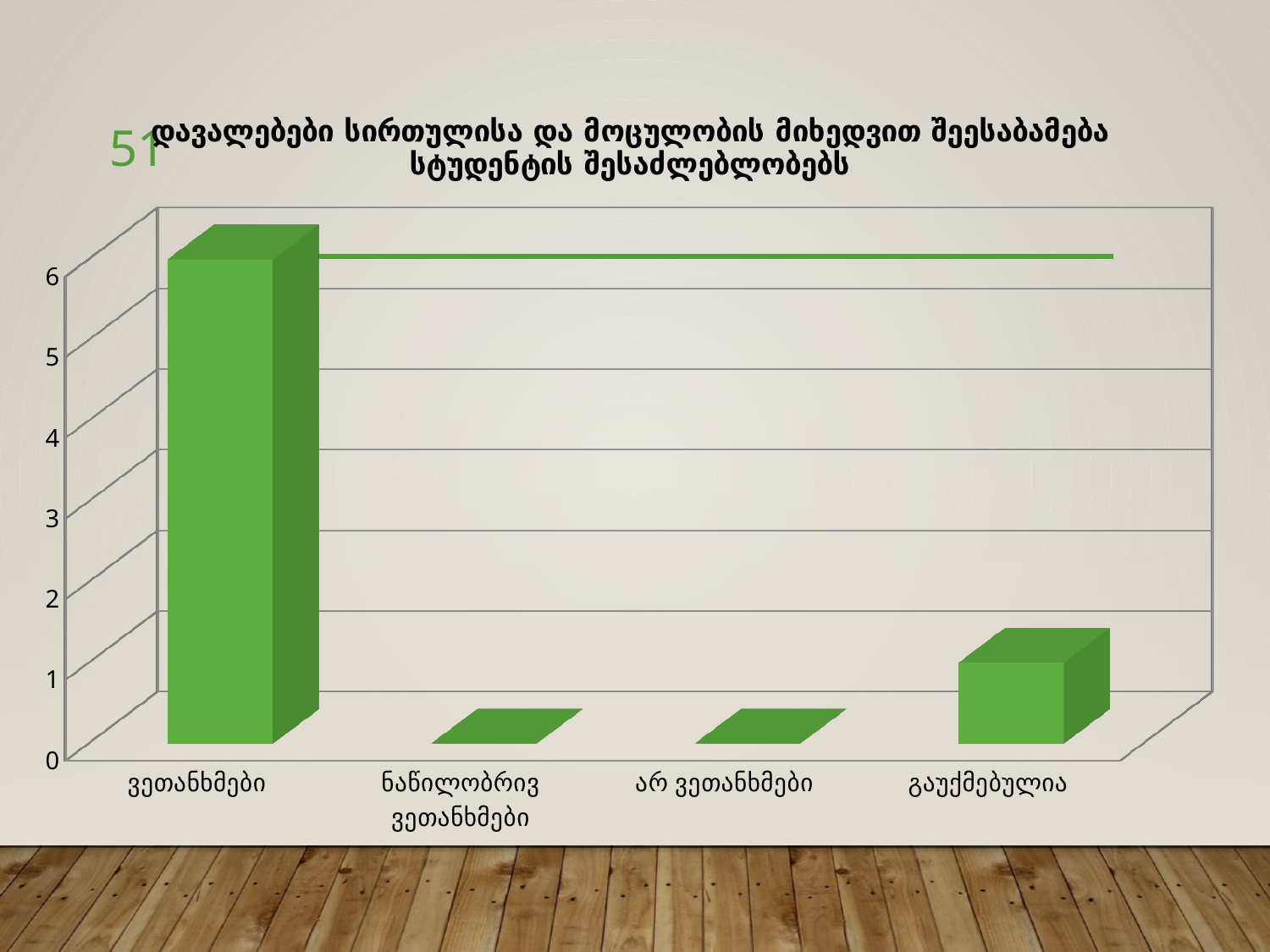
What is the highest tick value shown on the vertical axis of the chart? 6 What is the value for ნაწილობრივ ვეთანხმები? 0 How many categories in the chart have a value of 0? 2 Which is larger, the value for ვეთანხმები or the value for გაუქმებულია? ვეთანხმები What colour are the bars in the chart? green What is the value for არ ვეთანხმები? 0 Is the value for გაუქმებულია greater or less than 2? less Which is larger, the value for გაუქმებულია or the value for არ ვეთანხმები? გაუქმებულია What kind of chart is shown on the slide? bar chart Which category has the highest value in the chart? ვეთანხმები Is the value for ვეთანხმები greater or less than 5? greater How many categories are shown on the x axis of the chart? 4